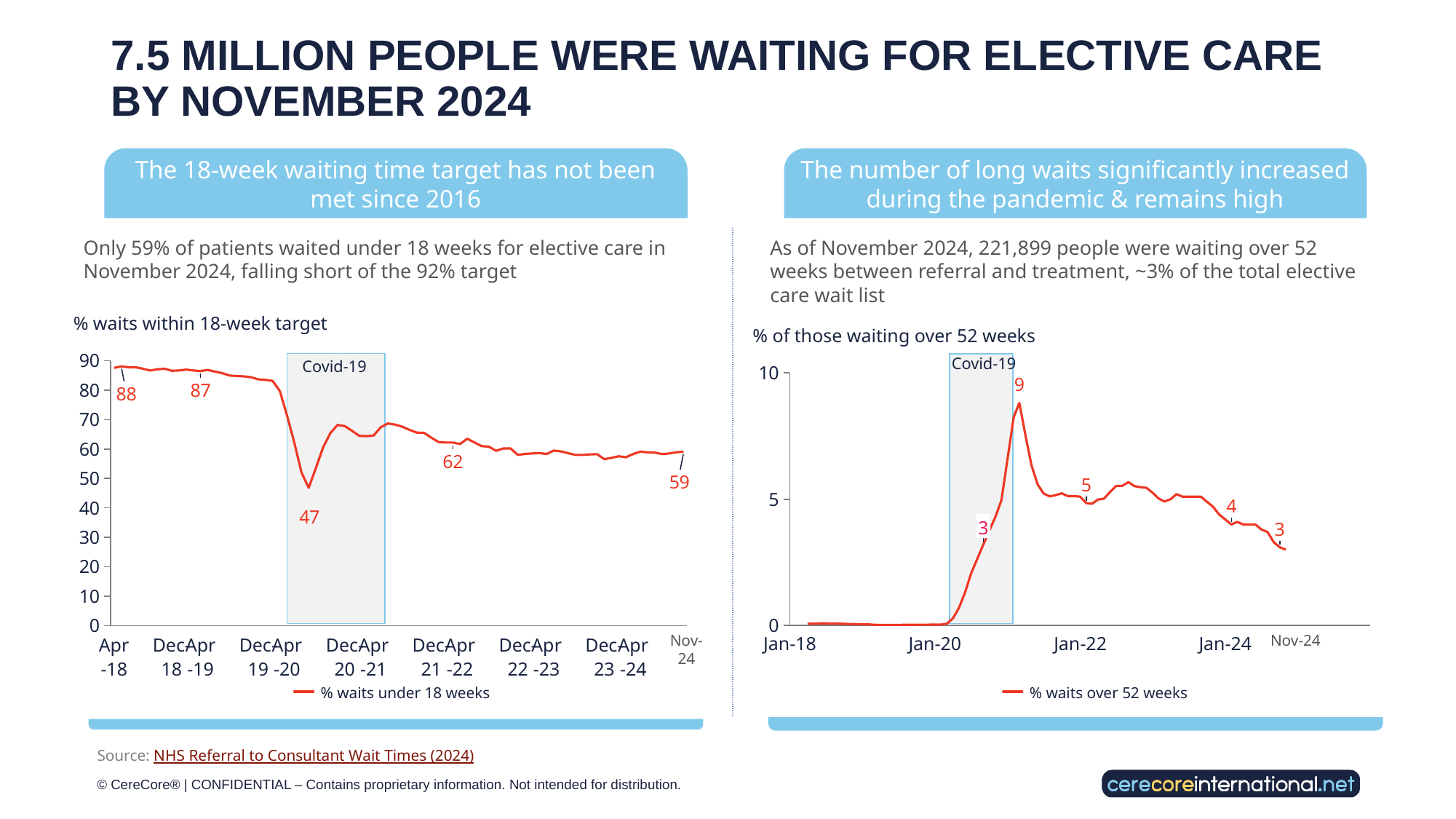
On the right chart '% of those waiting over 52 weeks', what is the difference between the peak value (9) and the Nov-24 value (3)? 6 On the left chart '% waits within 18-week target', what is the labelled value at the start of the series (Apr-18)? 88 On the right chart '% of those waiting over 52 weeks', what is the highest labelled value? 9 On the left chart '% waits within 18-week target', what is the labelled value at Nov-24? 59 What is the legend entry shown below the right chart '% of those waiting over 52 weeks'? % waits over 52 weeks On the left chart '% waits within 18-week target', what is the difference between the Apr-18 value (88) and the Nov-24 value (59)? 29 How many series does the legend of the left chart '% waits within 18-week target' list? 1 On the right chart '% of those waiting over 52 weeks', what is the labelled value at Nov-24? 3 On the left chart '% waits within 18-week target', what is the lowest labelled value, reached during the Covid-19 period? 47 On the right chart '% of those waiting over 52 weeks', is the value at Jan-18 greater or less than 5? less On the left chart '% waits within 18-week target', do the values generally rise or fall from Apr-18 to Nov-24? fall What kind of chart is the left chart titled '% waits within 18-week target'? line chart